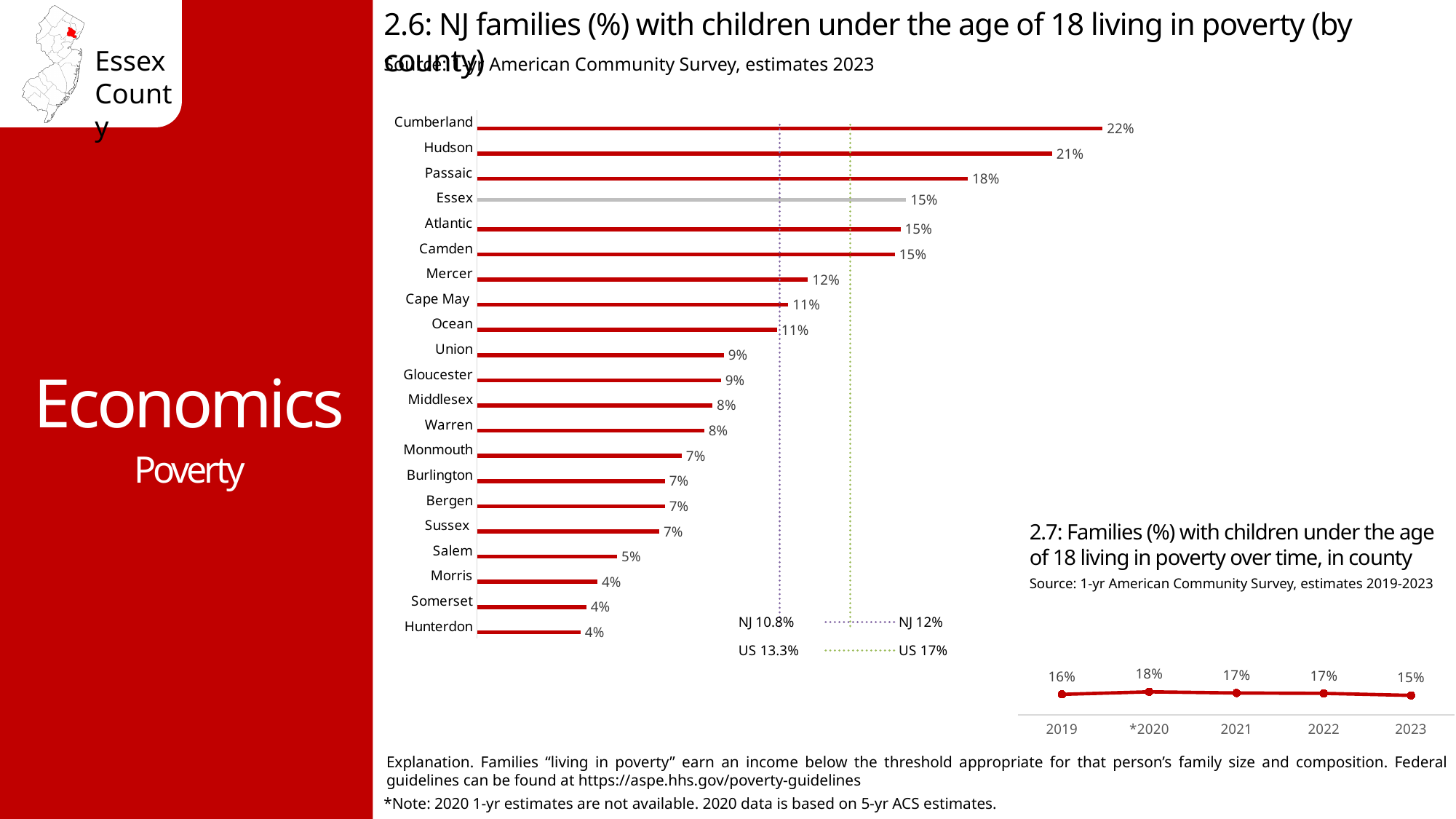
In chart 2.6, what is the value for Essex? 15% In chart 2.6, how many counties are plotted? 21 In chart 2.7, what is the value for 2023? 15% In chart 2.6, which is larger, the value for Passaic or the value for Mercer? Passaic What kind of chart is chart 2.6? Bar chart In chart 2.7, which year has the highest value? *2020 In chart 2.7, what is the difference between the 2020 value and the 2023 value? 3% In chart 2.6, which county has the highest percentage of families with children under 18 living in poverty? Cumberland In chart 2.6, what is the difference between Cumberland and Hunterdon? 18% In chart 2.7, how many years are plotted? 5 In chart 2.6, what is the value for Hudson? 21%